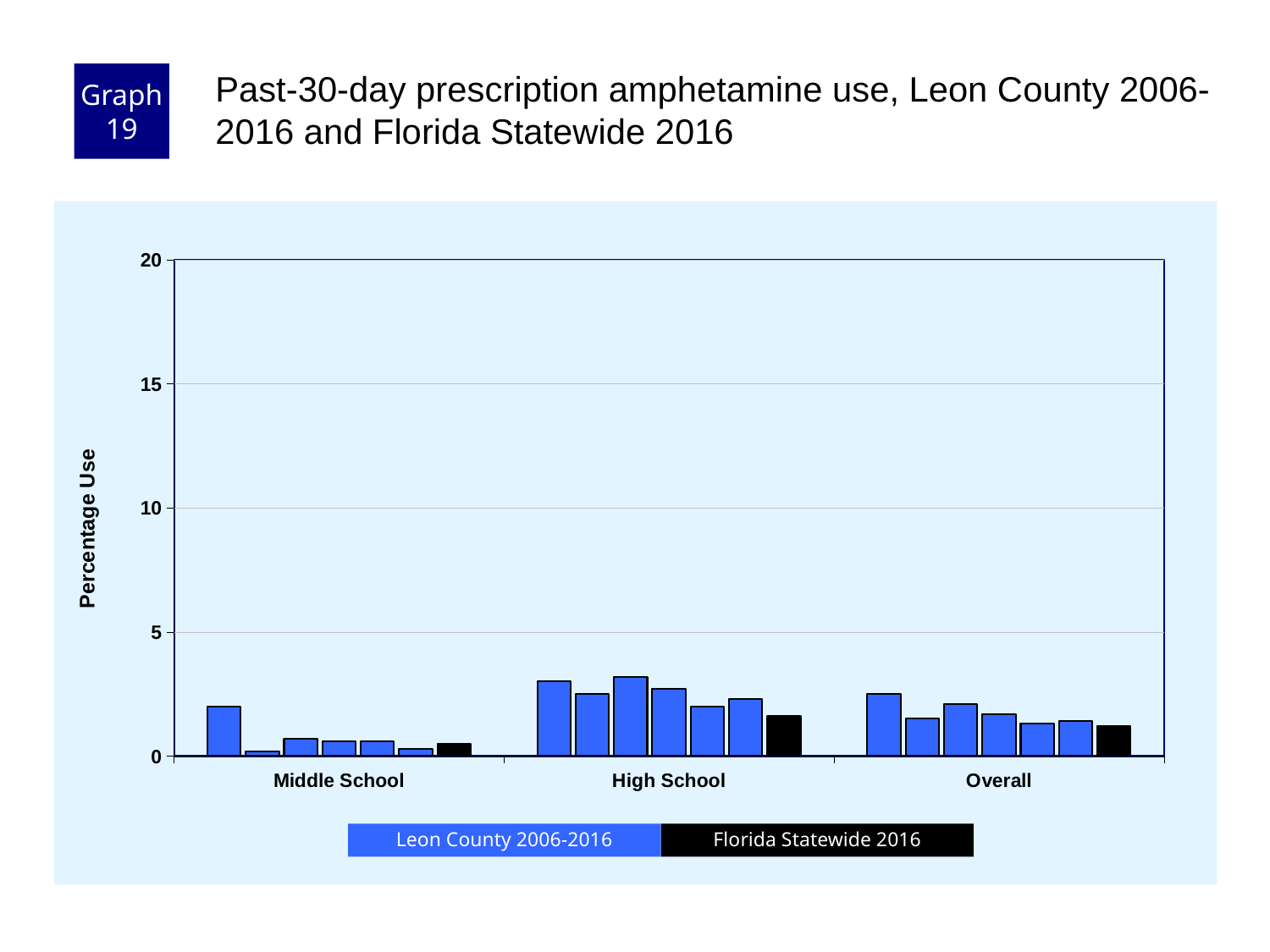
In the Middle School category, which is larger: the first Leon County bar or the Florida Statewide 2016 bar? The first Leon County bar How many series does the legend list? 2 What colour represents Florida Statewide 2016 in the legend? Black Which is larger: the Florida Statewide 2016 bar for High School or the Florida Statewide 2016 bar for Middle School? High School Is the Florida Statewide 2016 value for High School greater or less than 5? less How many categories are shown on the x axis? 3 Is the tallest Leon County bar in the Middle School category greater or less than 5? less What is the label on the y axis? Percentage Use In which category is the Florida Statewide 2016 bar the lowest? Middle School Which category has the tallest bars overall? High School How many bars are plotted in the High School category? 7 What kind of chart is shown on the slide? Bar chart